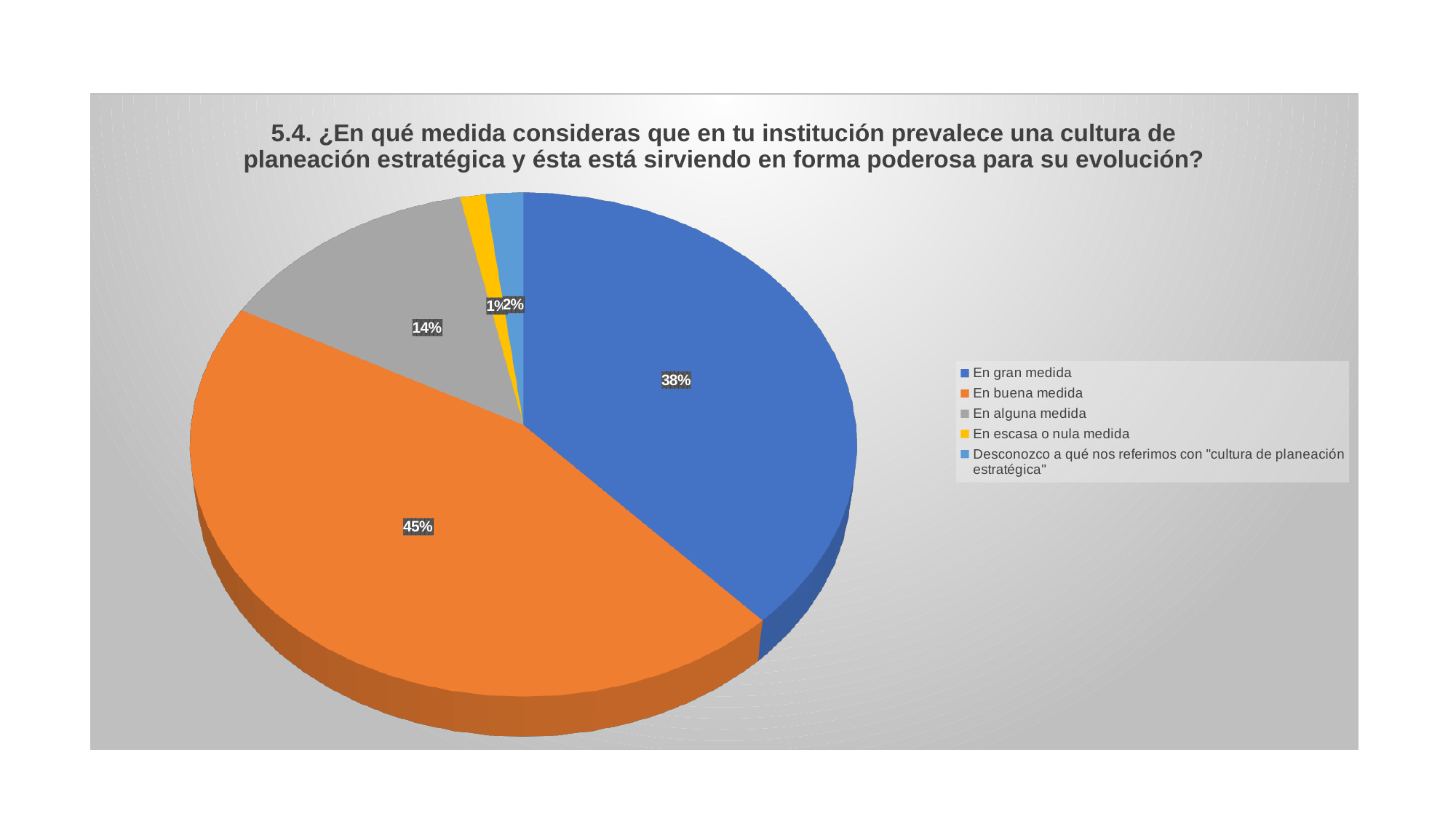
What share of the pie does "Desconozco a qué nos referimos con "cultura de planeación estratégica"" represent? 2% How many categories does the legend list? 5 Which is larger, the slice for "En gran medida" or the slice for "En alguna medida"? En gran medida What share of the pie does "En buena medida" represent? 45% What kind of chart is shown on the slide? Pie chart What share of the pie does "En alguna medida" represent? 14% What is the difference in percentage points between "En buena medida" and "En gran medida"? 7 Which category has the smallest slice of the pie? En escasa o nula medida What colour is the slice for "En alguna medida"? Grey Which category has the largest slice of the pie? En buena medida